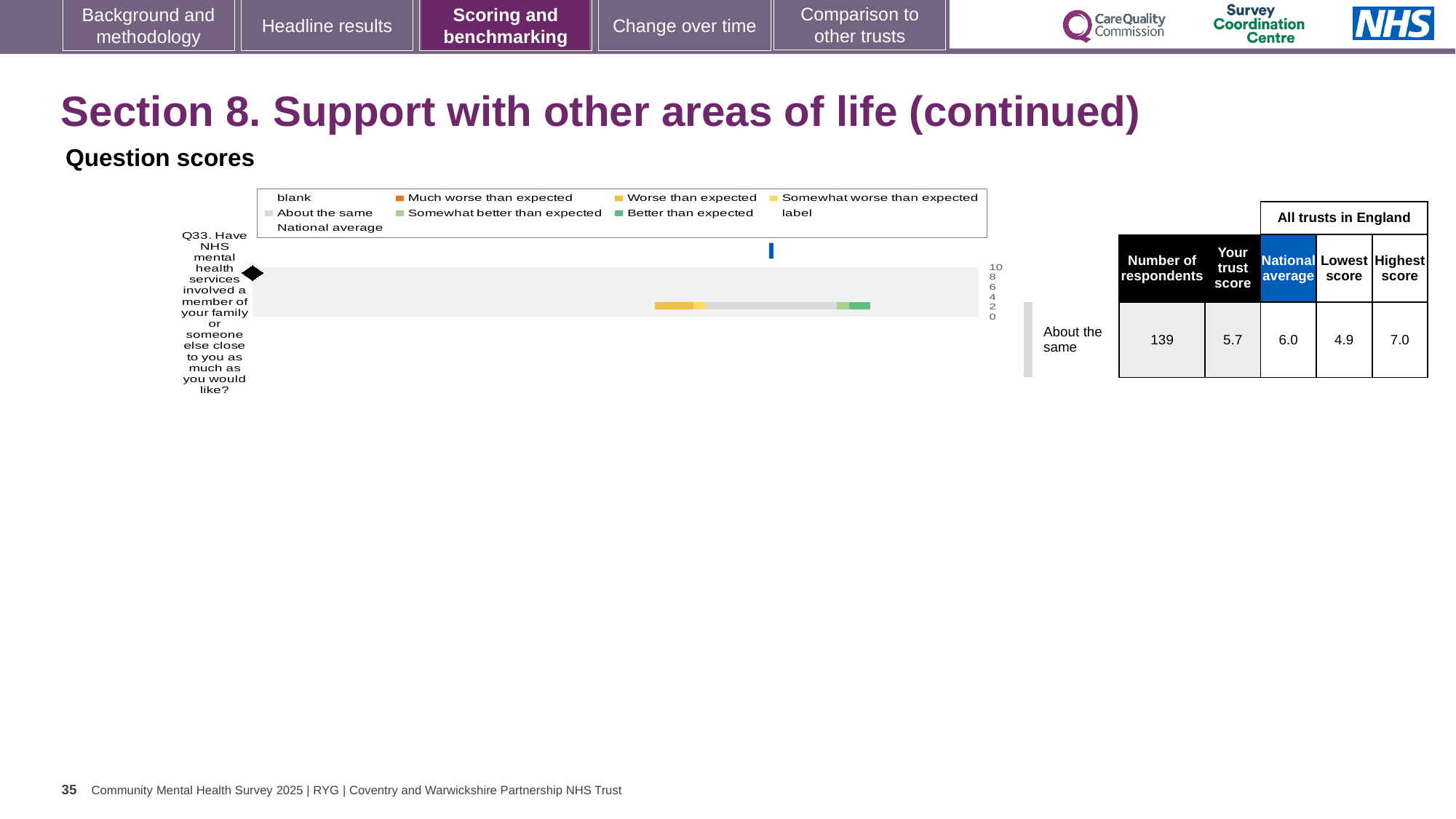
What benchmark category is given for Q33? About the same What is the lowest score among all trusts in England for Q33? 4.9 What is the trust's score for Q33? 5.7 Which is larger for Q33: the trust's score or the national average? national average How many entries does the chart legend list? 9 What is the highest score among all trusts in England for Q33? 7.0 What kind of chart is shown on the slide? bar chart What is the number of respondents for Q33? 139 How many questions (categories) are plotted in the chart? 1 What is the maximum value shown on the chart's score axis? 10 What is the difference between the highest and lowest scores for Q33 across all trusts in England? 2.1 What is the national average score for Q33? 6.0